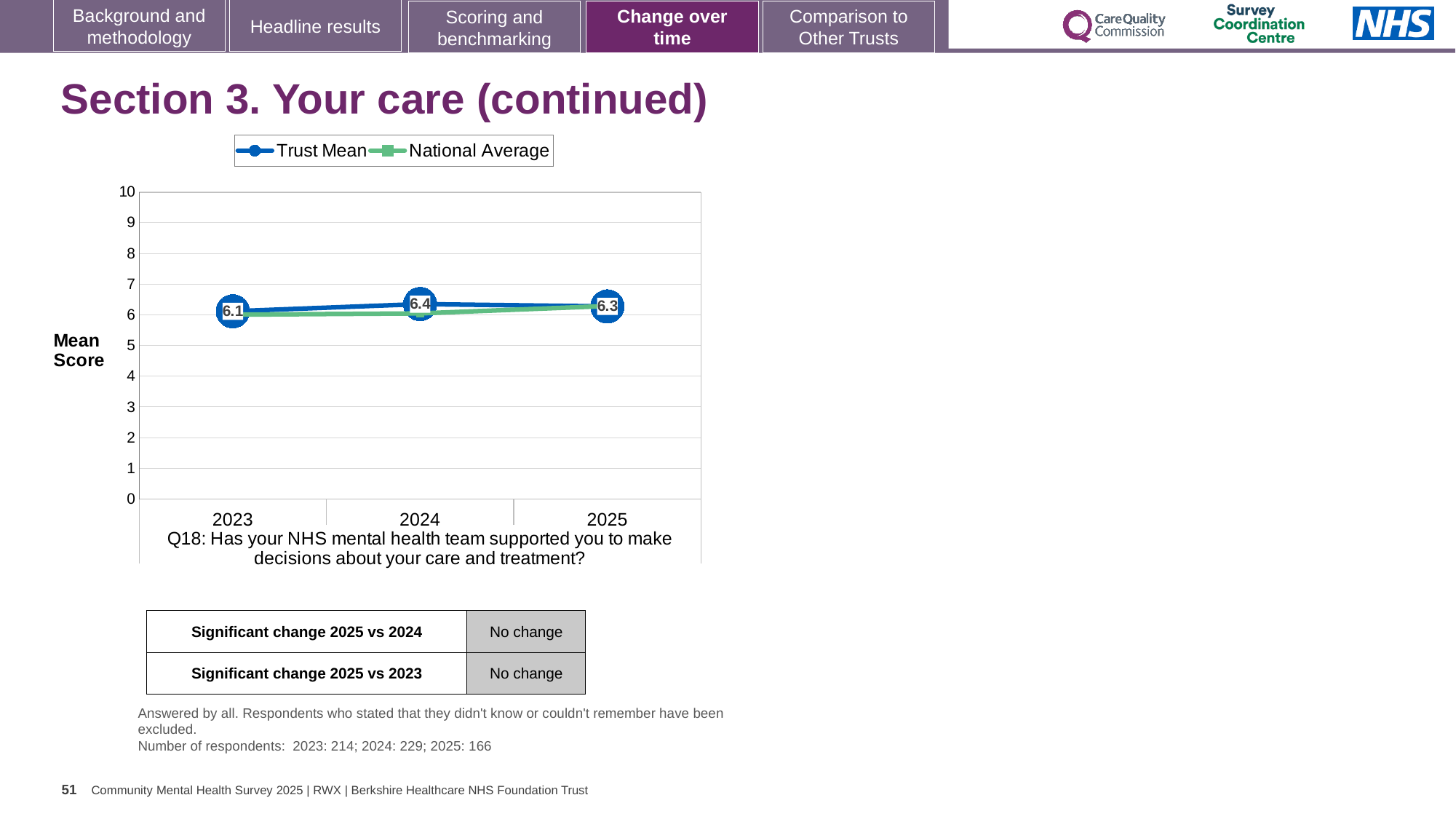
In which year is the Trust Mean lowest? 2023 What is the Trust Mean for 2024? 6.4 Is the National Average value for 2023 greater or less than 5? greater In which year is the Trust Mean highest? 2024 What kind of chart is shown on the slide? Line chart Does the Trust Mean rise or fall from 2023 to 2024? Rise Which is larger, the Trust Mean in 2024 or in 2025? 2024 What is the Trust Mean for 2023? 6.1 What is the difference between the Trust Mean in 2024 and in 2023? 0.3 What is the Trust Mean for 2025? 6.3 How many series does the legend list? 2 How many years are plotted on the x axis? 3